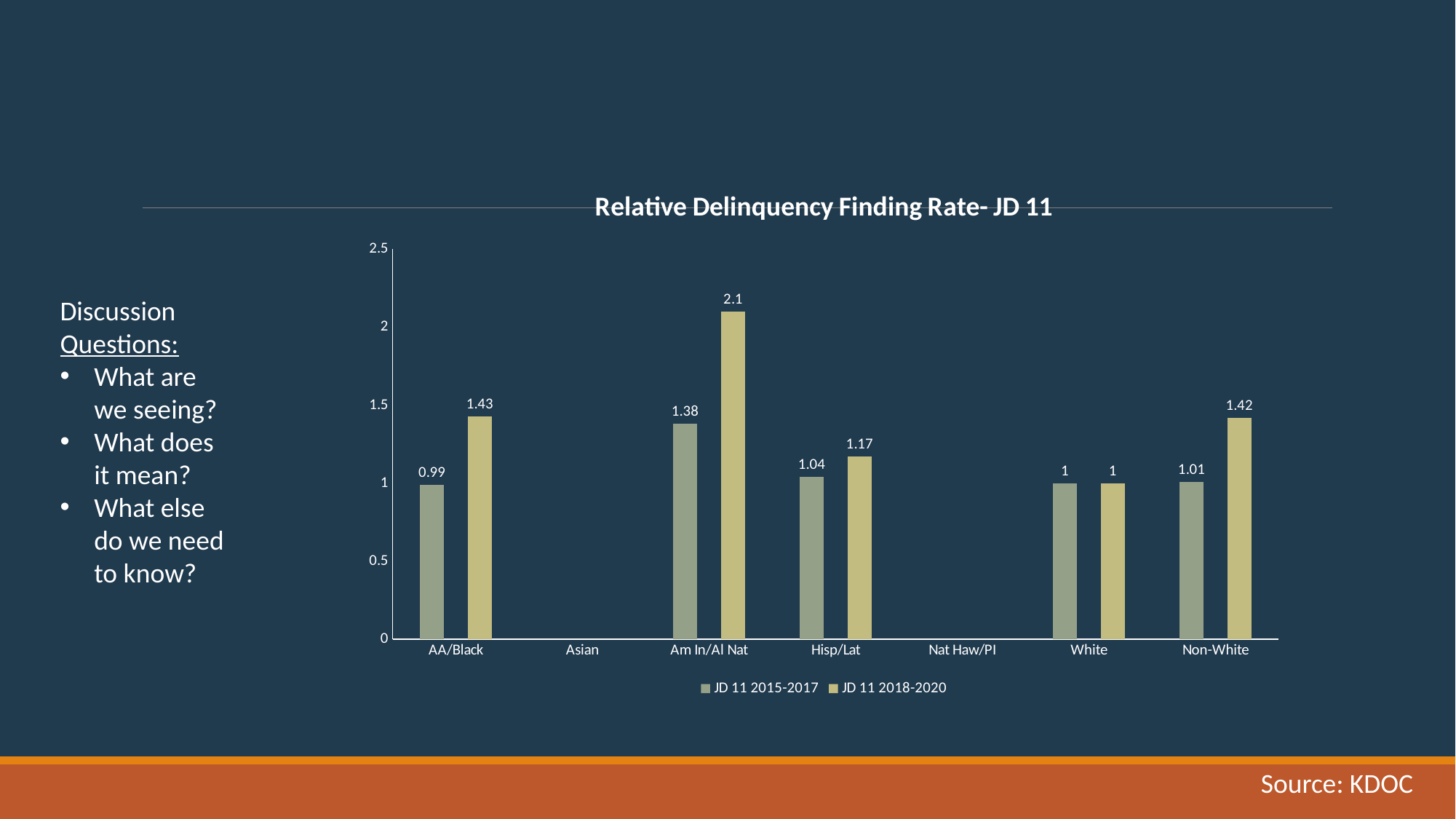
Is the JD 11 2018-2020 value for Am In/Al Nat greater or less than 2? greater How many categories are shown on the x axis? 7 What is the value for Am In/Al Nat in the JD 11 2015-2017 series? 1.38 What is the value for AA/Black in the JD 11 2018-2020 series? 1.43 How many series does the legend list? 2 What type of chart is shown on the slide? Bar chart Which category has the lowest value in the JD 11 2015-2017 series among those with bars shown? AA/Black Which is larger for AA/Black: the JD 11 2015-2017 value or the JD 11 2018-2020 value? JD 11 2018-2020 What is the value for Hisp/Lat in the JD 11 2018-2020 series? 1.17 What is the difference between the JD 11 2018-2020 and JD 11 2015-2017 values for Am In/Al Nat? 0.72 Which category has the highest value in the JD 11 2018-2020 series? Am In/Al Nat What is the value for Non-White in the JD 11 2015-2017 series? 1.01